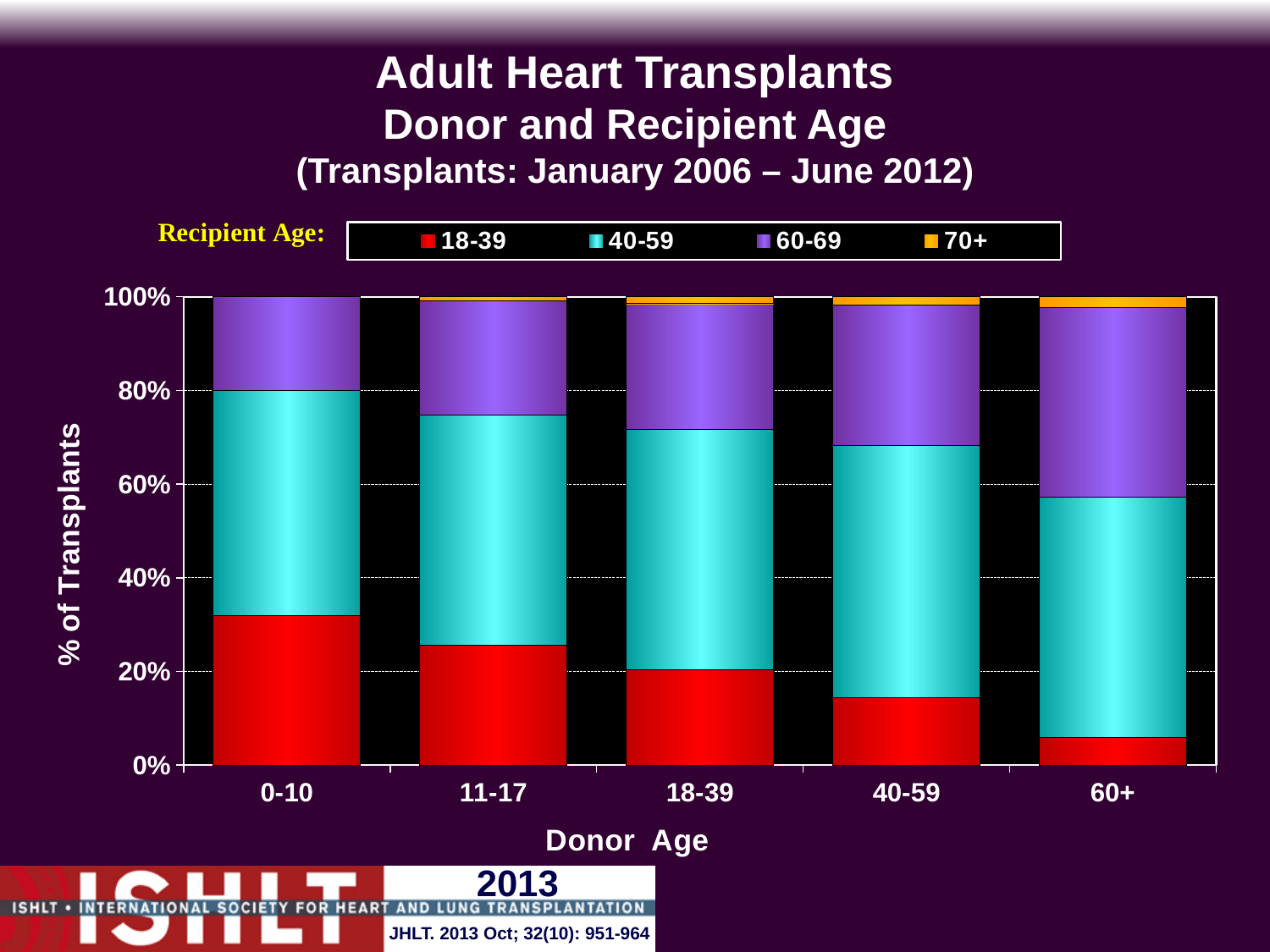
What kind of chart is shown on the slide? Stacked bar chart What is the label of the y axis? % of Transplants Is the share of 60-69 recipients larger for donor age 60+ or for donor age 0-10? 60+ Which donor age group has the largest share of 60-69 recipients? 60+ Which donor age group has the smallest share of 18-39 recipients? 60+ Does the share of 18-39 recipients rise or fall as donor age increases along the x axis? fall Is the share of 18-39 recipients for donor age 40-59 greater or less than 20%? less Is the share of 18-39 recipients for donor age 0-10 greater or less than 20%? greater Is the share of 18-39 recipients for donor age 60+ greater or less than 20%? less How many donor age categories are shown on the x axis? 5 Which donor age group has the largest share of 18-39 recipients? 0-10 How many recipient age groups does the legend list? 4